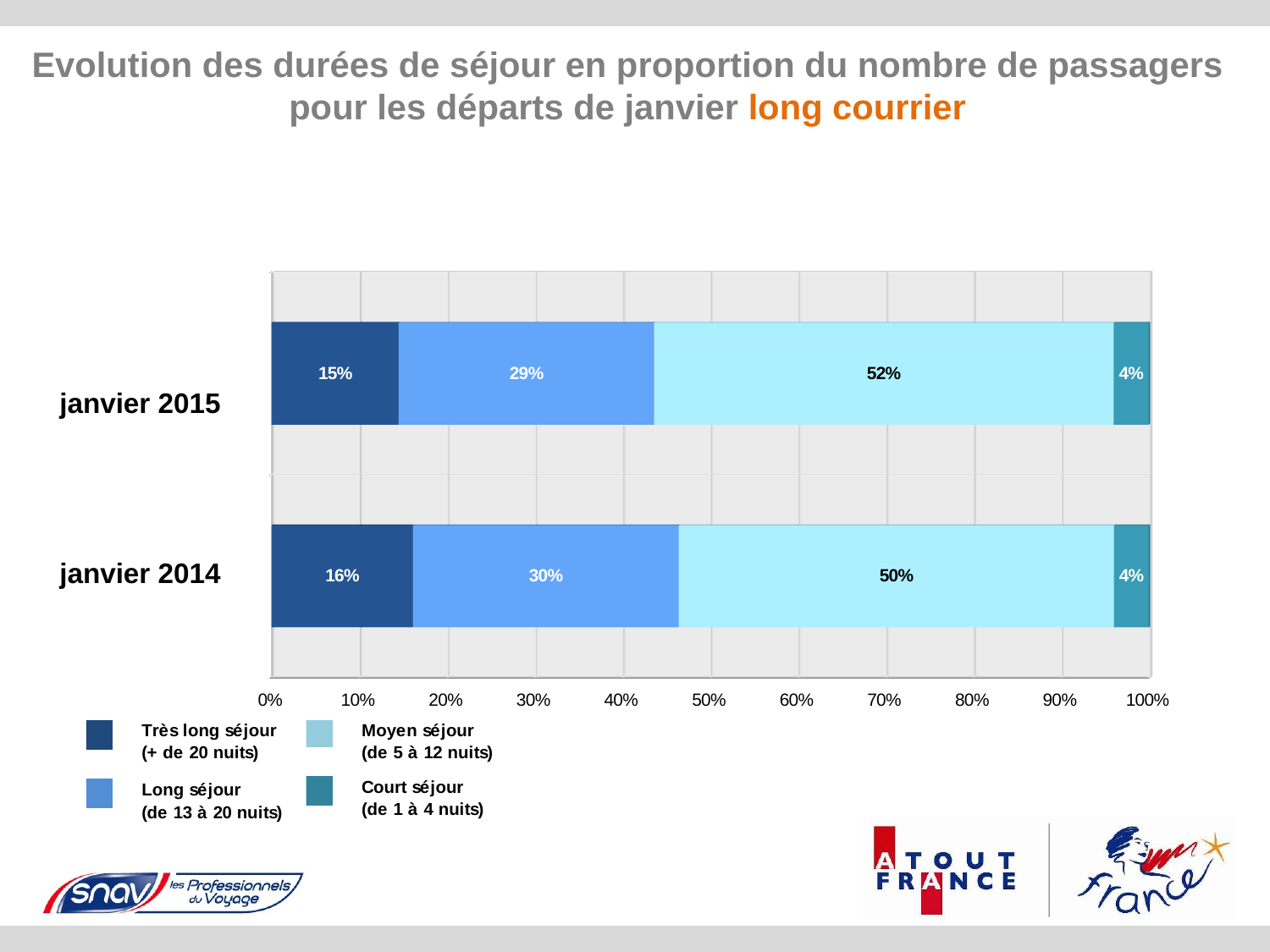
What is the difference between the Moyen séjour values for janvier 2015 and janvier 2014? 2% What is the value for Très long séjour (+ de 20 nuits) in janvier 2014? 16% How many series does the legend list? 4 What is the total of the janvier 2015 stacked bar? 100% What is the value for Moyen séjour (de 5 à 12 nuits) in janvier 2015? 52% Which segment is the largest in the janvier 2015 bar? Moyen séjour (de 5 à 12 nuits) Which is larger: Long séjour in janvier 2014 or Long séjour in janvier 2015? janvier 2014 What is the value for Long séjour (de 13 à 20 nuits) in janvier 2015? 29% How many categories (bars) are shown on the chart? 2 What kind of chart is shown on the slide? Stacked bar chart What is the value for Court séjour (de 1 à 4 nuits) in janvier 2014? 4% Which segment is the smallest in the janvier 2014 bar? Court séjour (de 1 à 4 nuits)